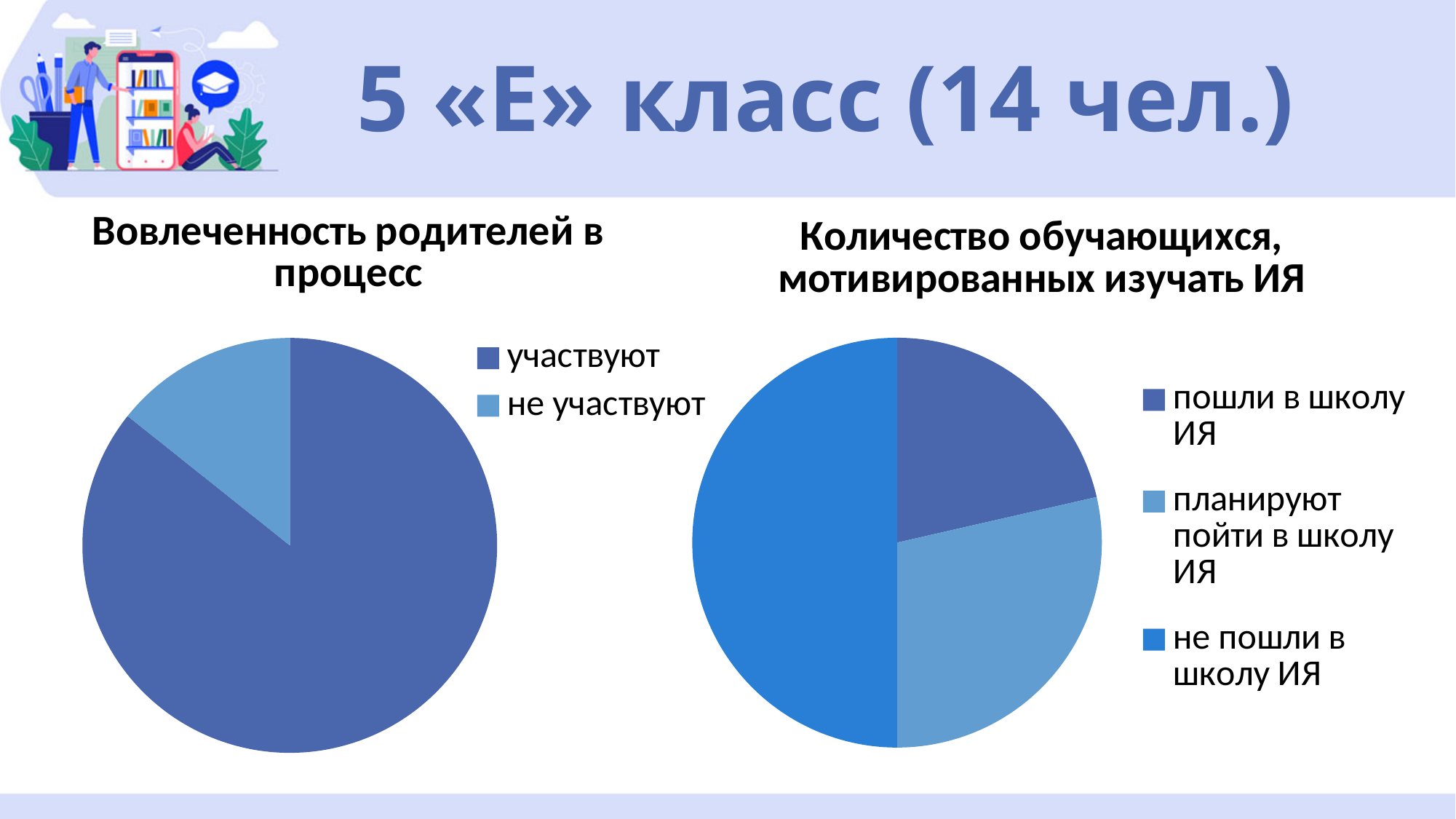
In the chart "Вовлеченность родителей в процесс", how many slices does the pie have? 2 In the chart "Вовлеченность родителей в процесс", how many entries does the legend list? 2 In the chart "Вовлеченность родителей в процесс", which category has the largest slice? участвуют In the chart "Вовлеченность родителей в процесс", which category has the smallest slice? не участвуют In the chart "Количество обучающихся, мотивированных изучать ИЯ", which category has the smallest slice? пошли в школу ИЯ What is the title of the pie chart on the left side of the slide? Вовлеченность родителей в процесс In the chart "Количество обучающихся, мотивированных изучать ИЯ", how many entries does the legend list? 3 What kind of chart is the chart titled "Количество обучающихся, мотивированных изучать ИЯ"? pie chart In the chart "Количество обучающихся, мотивированных изучать ИЯ", which slice is larger: "не пошли в школу ИЯ" or "планируют пойти в школу ИЯ"? не пошли в школу ИЯ In the chart "Количество обучающихся, мотивированных изучать ИЯ", how many slices does the pie have? 3 What kind of chart is the chart titled "Вовлеченность родителей в процесс"? pie chart In the chart "Количество обучающихся, мотивированных изучать ИЯ", which category has the largest slice? не пошли в школу ИЯ